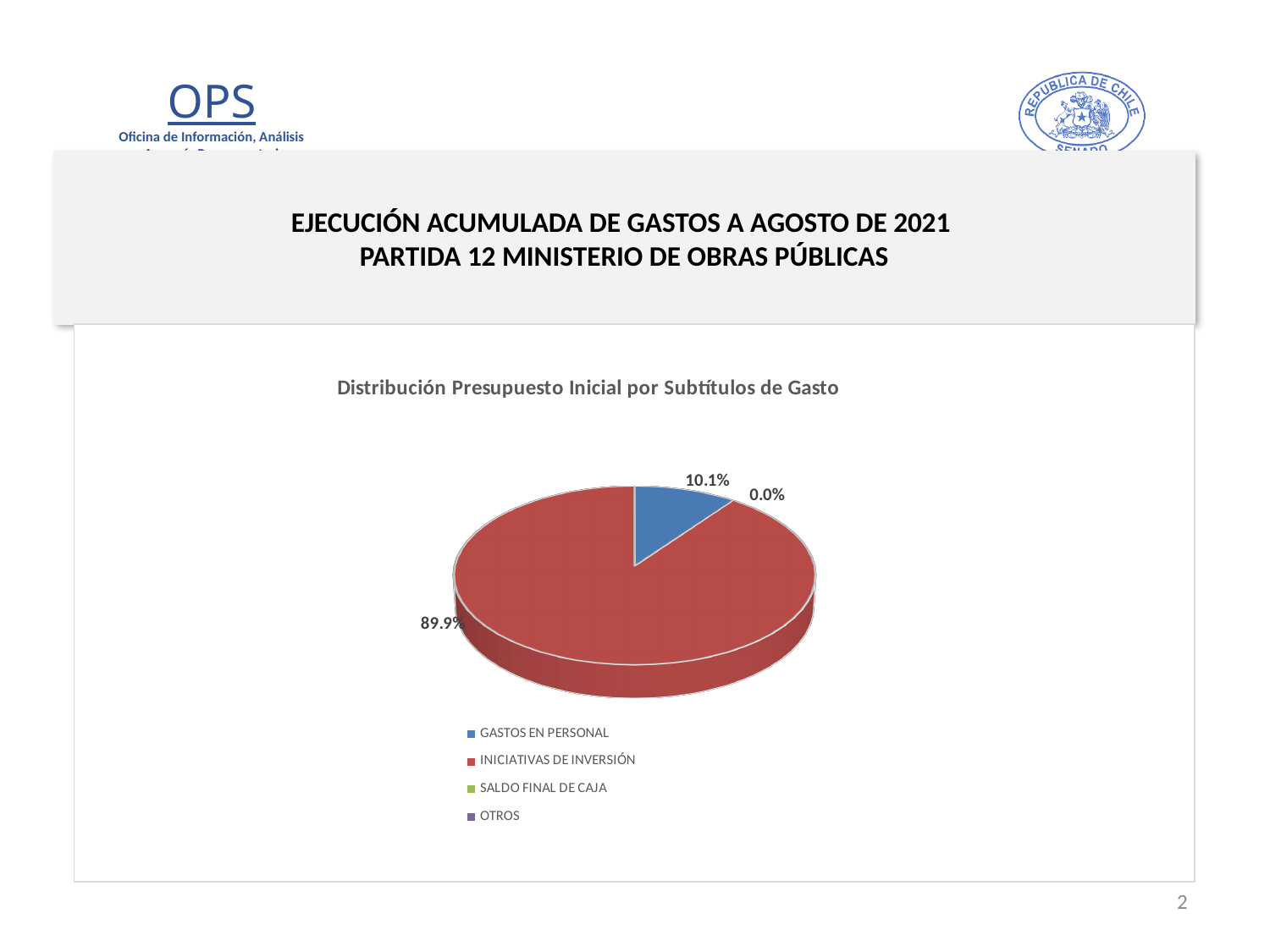
What colour is the slice for INICIATIVAS DE INVERSIÓN? red How many categories does the legend list? 4 What kind of chart is shown on the slide? pie chart What is the title of the chart? Distribución Presupuesto Inicial por Subtítulos de Gasto Which is larger, GASTOS EN PERSONAL or INICIATIVAS DE INVERSIÓN? INICIATIVAS DE INVERSIÓN Which category has the largest slice of the pie? INICIATIVAS DE INVERSIÓN Is the share for GASTOS EN PERSONAL greater or less than 50%? less What is the difference in percentage points between INICIATIVAS DE INVERSIÓN and GASTOS EN PERSONAL? 79.8 percentage points What share of the pie does GASTOS EN PERSONAL represent? 10.1% What is the value shown for INICIATIVAS DE INVERSIÓN? 89.9%